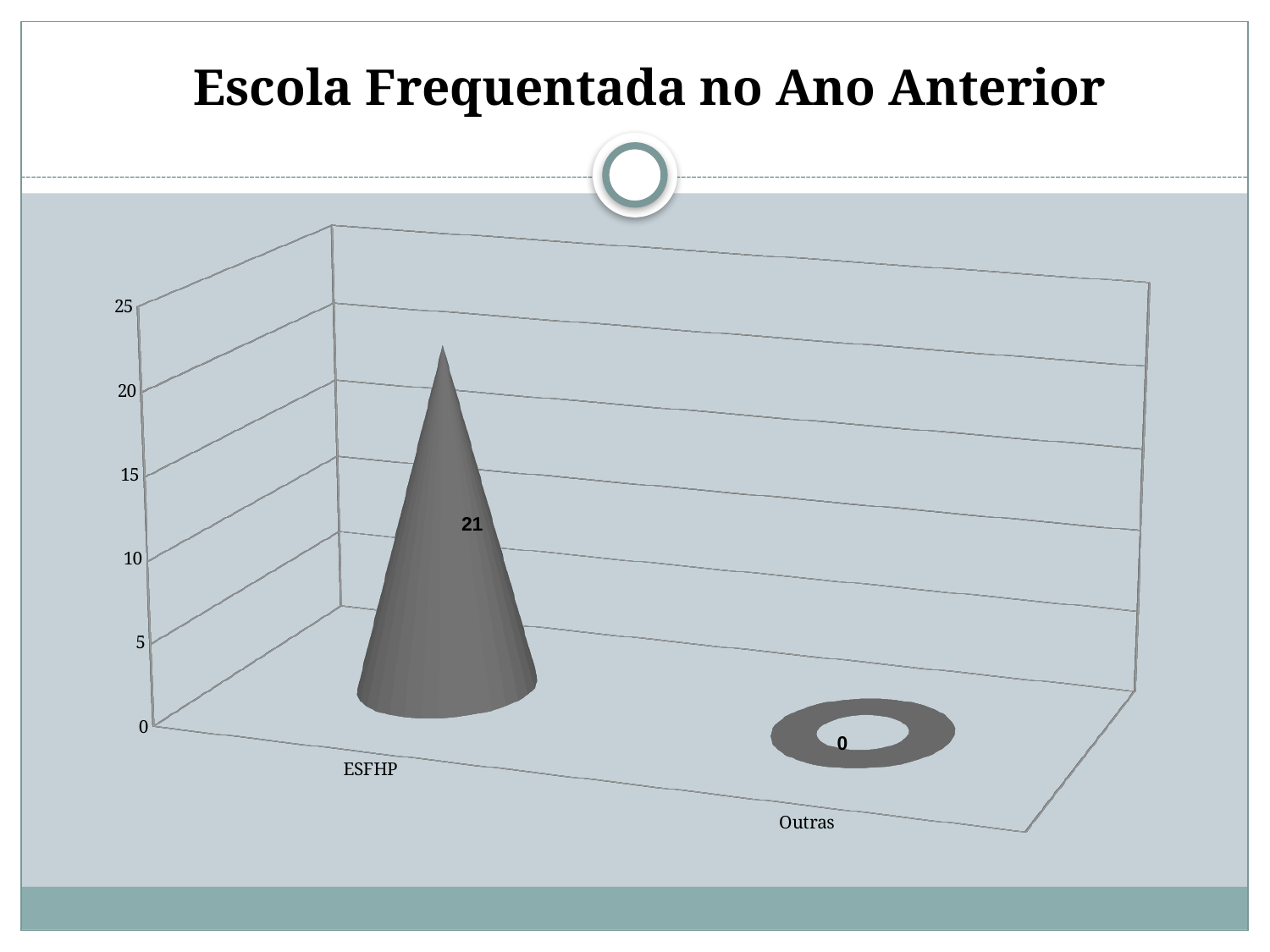
Is the value for ESFHP greater or less than 20? greater What is the value for ESFHP? 21 What is the difference between the values for ESFHP and Outras? 21 What is the title of the slide? Escola Frequentada no Ano Anterior How many categories are shown on the x axis? 2 Which category has the highest value? ESFHP Which is larger, the value for ESFHP or the value for Outras? ESFHP Which category has the lowest value? Outras Is the value for ESFHP greater or less than 25? less What kind of chart is shown on the slide? bar chart What is the maximum value shown on the vertical axis? 25 What is the value for Outras? 0